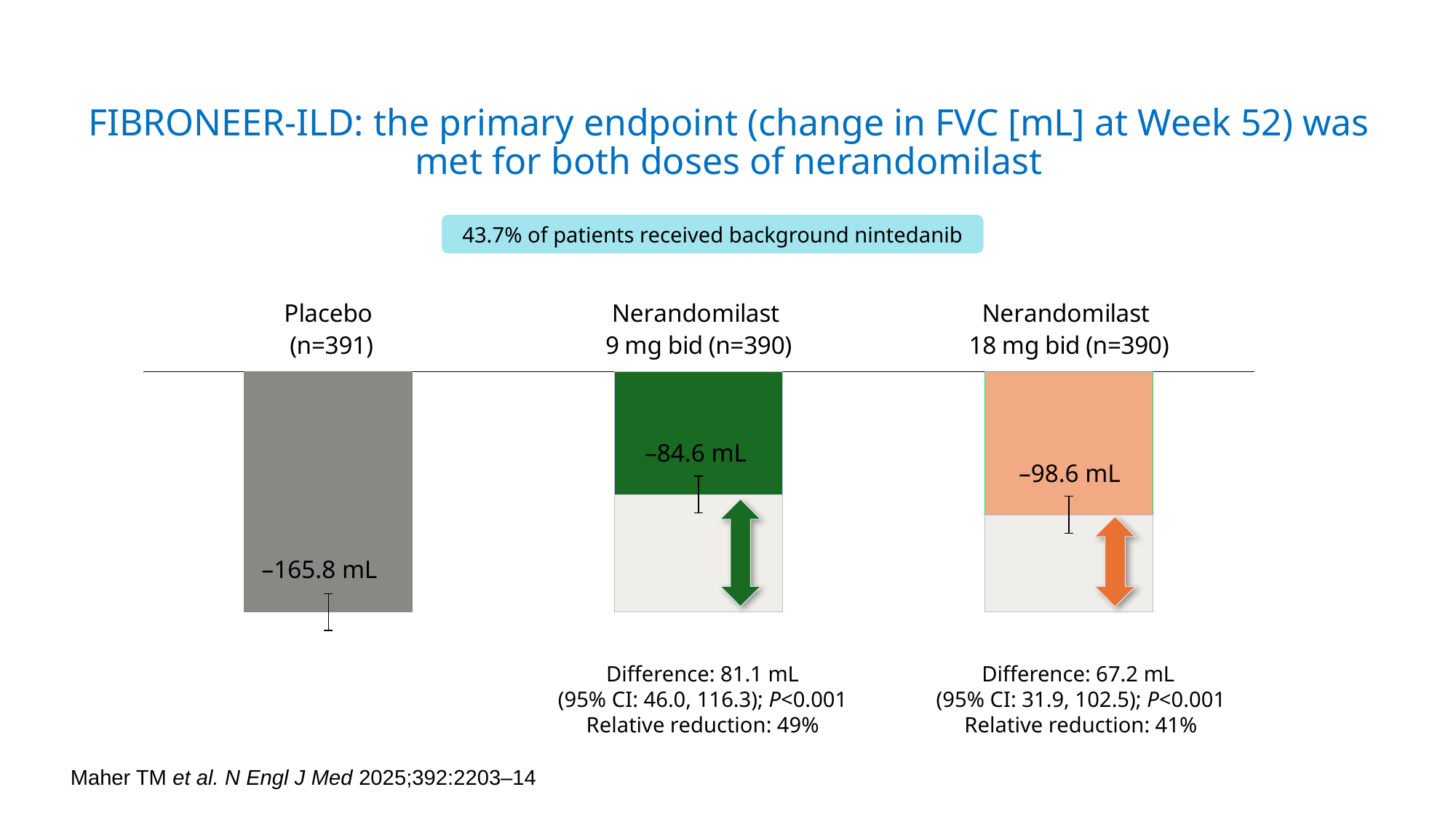
What is the change in FVC at Week 52 for the Placebo group? –165.8 mL What is the change in FVC at Week 52 for Nerandomilast 9 mg bid? –84.6 mL What kind of chart is shown on the slide? Bar chart How many patients were in the Placebo group? 391 Which group shows the smallest decline in FVC at Week 52? Nerandomilast 9 mg bid What is the change in FVC at Week 52 for Nerandomilast 18 mg bid? –98.6 mL How many treatment groups are shown in the chart? 3 What is the relative reduction in FVC decline for Nerandomilast 18 mg bid versus Placebo? 41% Which group has a larger decline in FVC: Nerandomilast 9 mg bid or Nerandomilast 18 mg bid? Nerandomilast 18 mg bid What is the difference in FVC change between Nerandomilast 9 mg bid and Placebo, as printed on the slide? 81.1 mL Which group shows the largest decline in FVC at Week 52? Placebo What is the difference in FVC change between Nerandomilast 18 mg bid and Placebo, as printed on the slide? 67.2 mL